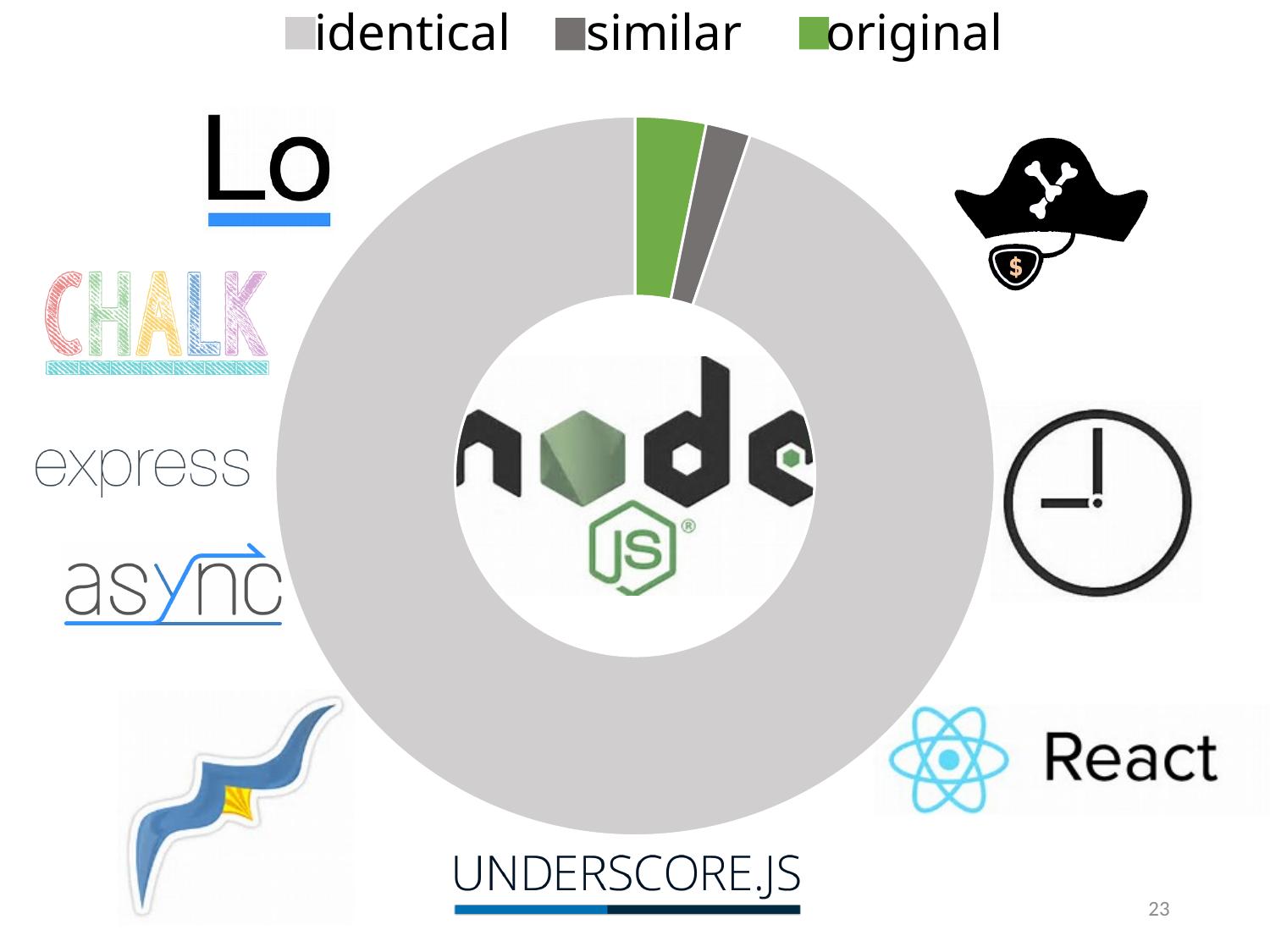
What colour represents the 'original' category in the chart? green Which is larger in the chart, the share for identical or the share for similar? identical Which category takes up the largest share of the chart? identical How many categories does the chart's legend list? 3 What are the three legend entries of the chart, in order? identical, similar, original What kind of chart is shown on the slide? doughnut chart Which category takes up the smallest share of the chart? similar Which is larger in the chart, the share for identical or the share for original? identical